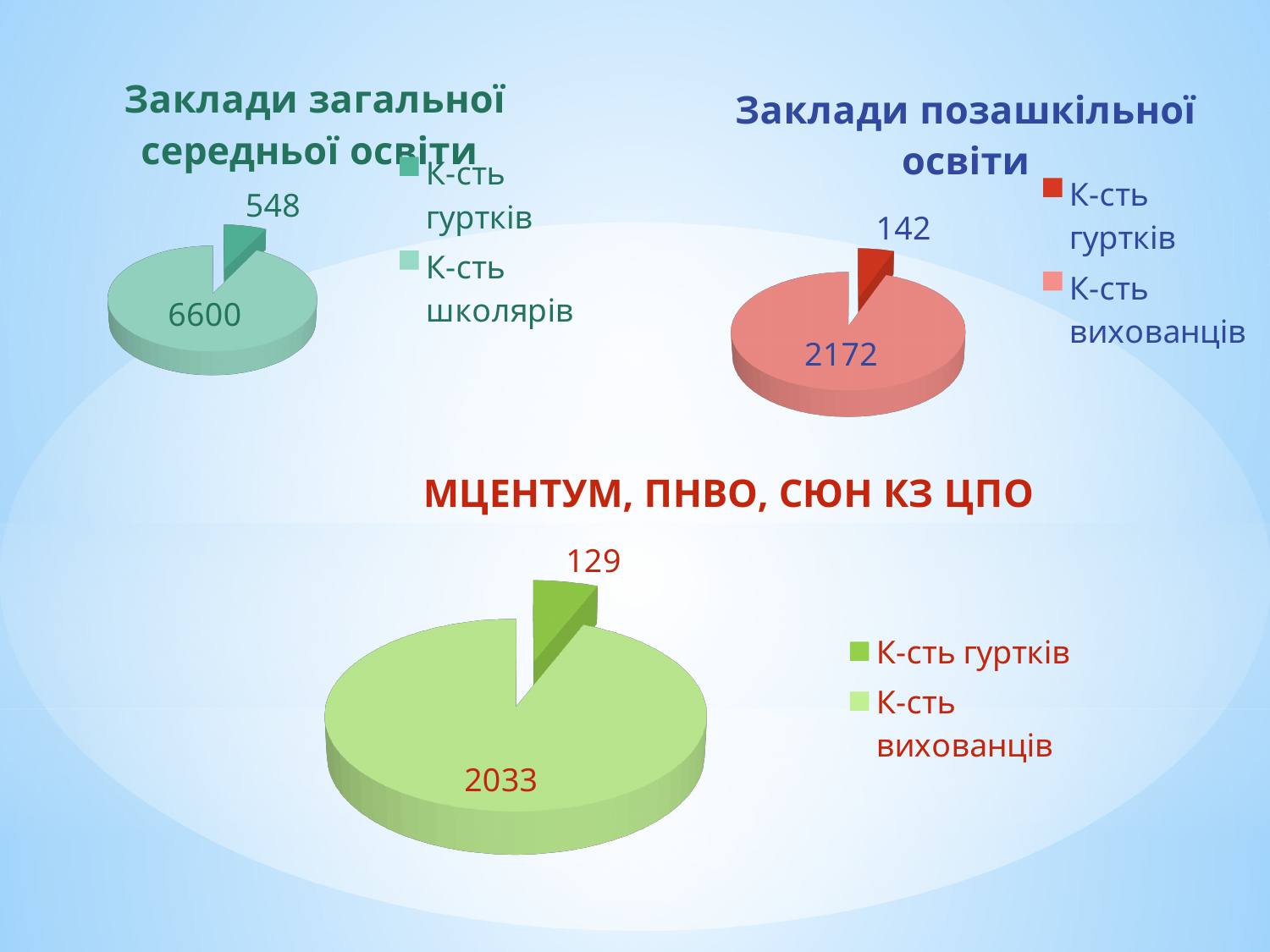
In the chart titled "Заклади позашкільної освіти", what is the value for К-сть гуртків? 142 In the chart titled "Заклади загальної середньої освіти", what is the value for К-сть школярів? 6600 In the chart titled "Заклади позашкільної освіти", which category has the smallest slice? К-сть гуртків What kind of chart is the chart titled "МЦЕНТУМ, ПНВО, СЮН КЗ ЦПО"? pie chart In the chart titled "МЦЕНТУМ, ПНВО, СЮН КЗ ЦПО", what is the value for К-сть вихованців? 2033 In the chart titled "Заклади позашкільної освіти", what is the value for К-сть вихованців? 2172 How many slices does the chart titled "Заклади загальної середньої освіти" have? 2 In the chart titled "Заклади загальної середньої освіти", which category has the largest slice? К-сть школярів In the chart titled "Заклади загальної середньої освіти", what is the value for К-сть гуртків? 548 In the chart titled "Заклади позашкільної освіти", what is the total of the two slices? 2314 In the chart titled "МЦЕНТУМ, ПНВО, СЮН КЗ ЦПО", what is the difference between К-сть вихованців and К-сть гуртків? 1904 In the chart titled "МЦЕНТУМ, ПНВО, СЮН КЗ ЦПО", what is the value for К-сть гуртків? 129